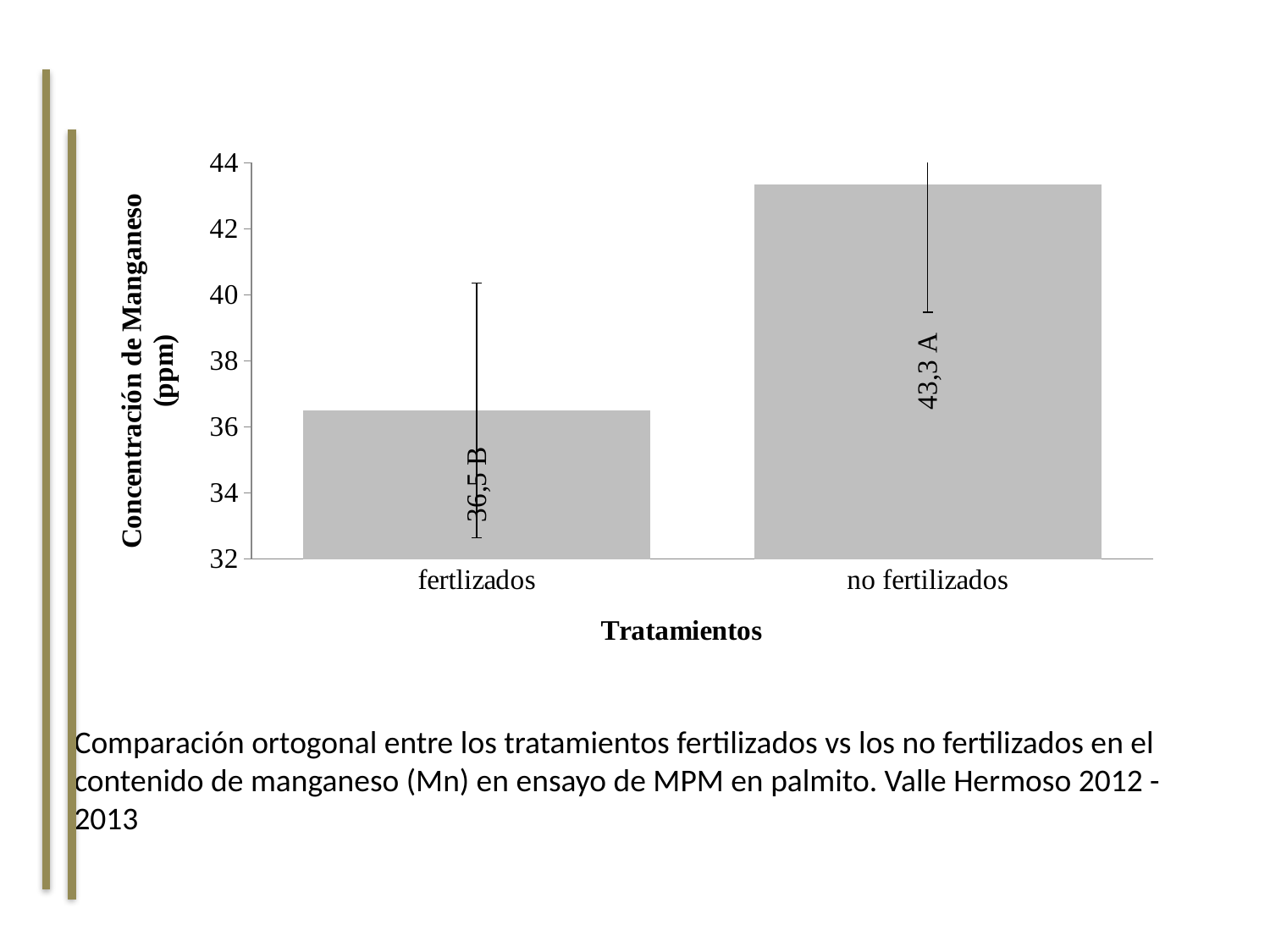
What is the manganese concentration value labelled on the bar for no fertilizados? 43,3 Is the manganese concentration for no fertilizados greater or less than 42? greater What kind of chart is shown on the slide? bar chart What is the title of the x axis? Tratamientos What is the difference in manganese concentration between no fertilizados and fertlizados? 6,8 What is the manganese concentration value labelled on the bar for fertlizados? 36,5 What is the title of the y axis? Concentración de Manganeso (ppm) What statistical group letter is shown next to the value for no fertilizados? A Is the manganese concentration for fertlizados greater or less than 40? less How many treatment categories are shown on the x axis? 2 Which treatment has the lower manganese concentration? fertlizados Which treatment has the higher manganese concentration? no fertilizados